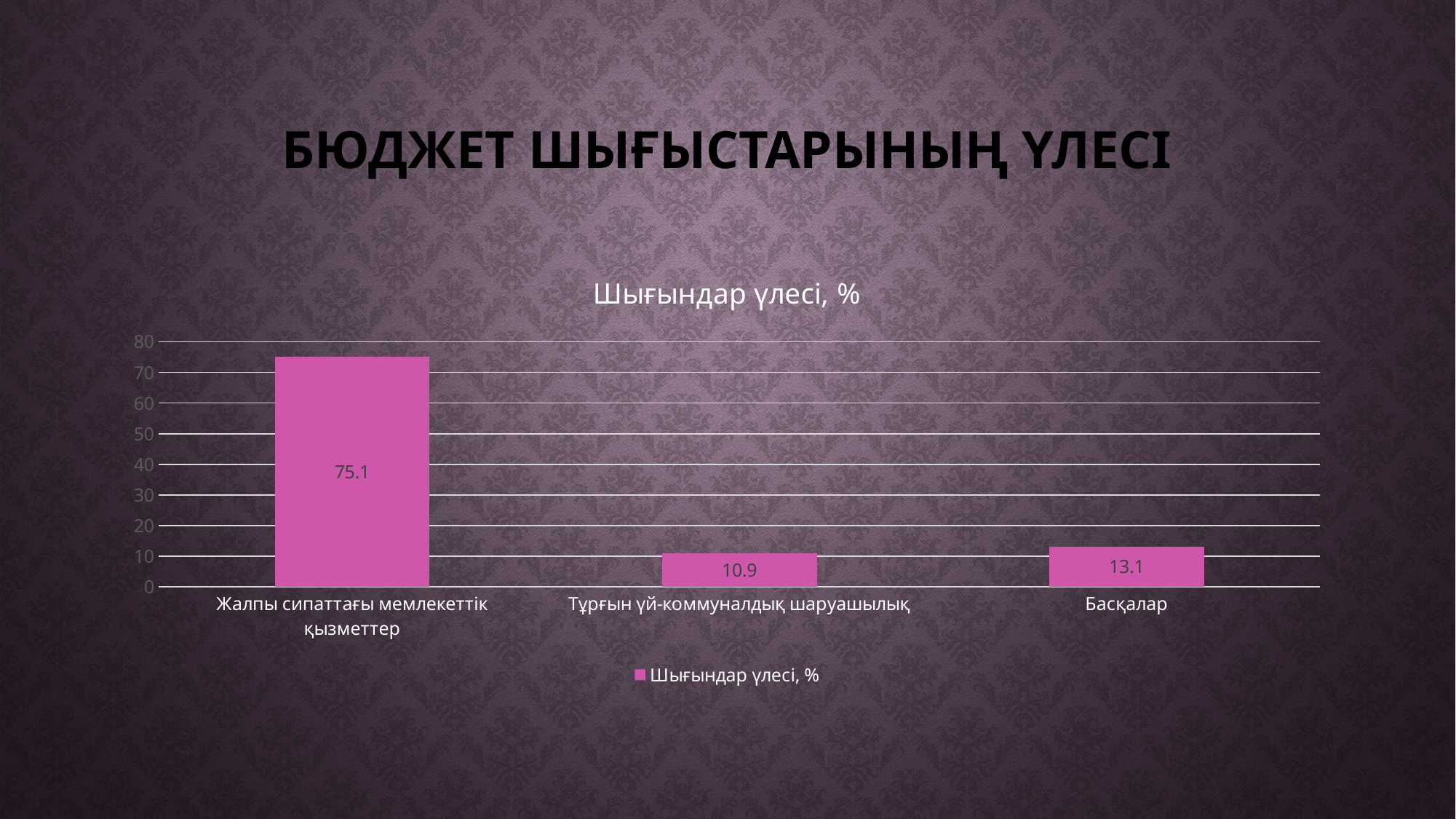
What is the value for Жалпы сипаттағы мемлекеттік қызметтер? 75.1 Which category has the highest value? Жалпы сипаттағы мемлекеттік қызметтер What is the difference between the values for Жалпы сипаттағы мемлекеттік қызметтер and Басқалар? 62 What is the difference between the values for Басқалар and Тұрғын үй-коммуналдық шаруашылық? 2.2 Is the value for Жалпы сипаттағы мемлекеттік қызметтер greater or less than 70? greater How many categories are shown on the x axis? 3 What is the value for Тұрғын үй-коммуналдық шаруашылық? 10.9 What kind of chart is shown on the slide? bar chart What is the value for Басқалар? 13.1 Which is larger, the value for Басқалар or the value for Тұрғын үй-коммуналдық шаруашылық? Басқалар What is the title of the chart? Шығындар үлесі, % Which category has the lowest value? Тұрғын үй-коммуналдық шаруашылық